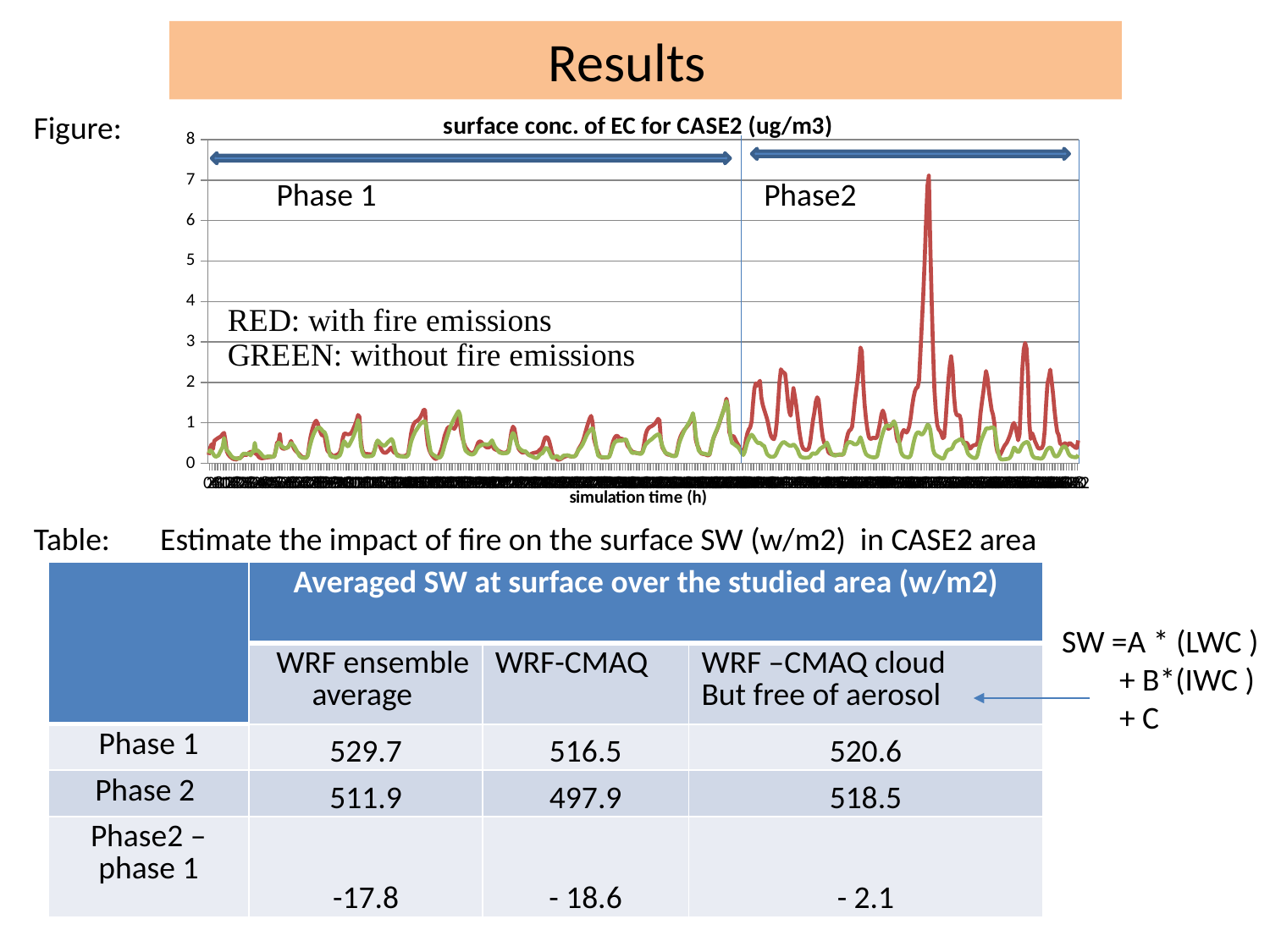
What is the title of the chart? surface conc. of EC for CASE2 (ug/m3) Which colour represents the series with fire emissions? red In which phase does the red (with fire emissions) series reach its highest peak? Phase2 Is the highest peak of the red series in Phase 1 greater or less than 2? less Is the highest value of the green (without fire emissions) series greater or less than 2? less How many series are plotted on the chart? 2 In Phase 2, which series reaches higher values, red (with fire emissions) or green (without fire emissions)? red (with fire emissions) Is the highest peak of the red (with fire emissions) series greater or less than 6? greater What kind of chart is shown on the slide? line chart What is the maximum value shown on the y axis? 8